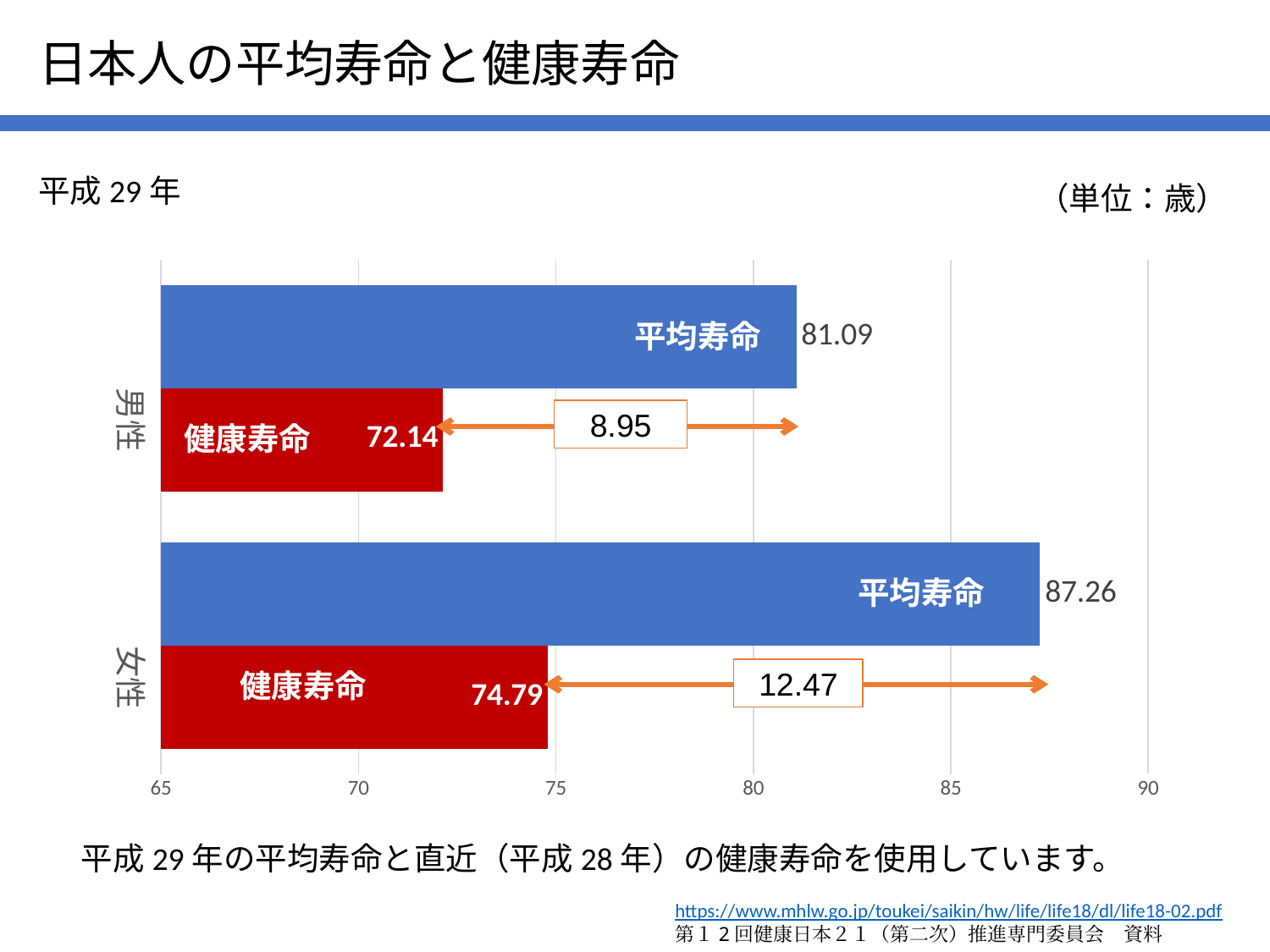
How many categories (groups) are shown on the chart? 2 What unit is indicated for the values on the chart? 歳 What kind of chart is shown on the slide? bar chart Which of the four plotted values is the lowest? 男性 健康寿命 (72.14) What is the difference between 平均寿命 and 健康寿命 for 男性? 8.95 Which group has the higher 平均寿命, 男性 or 女性? 女性 Is the 健康寿命 value for 女性 greater or less than 75? less What is the 健康寿命 value for 女性? 74.79 What is the 平均寿命 value for 男性? 81.09 What is the 平均寿命 value for 女性? 87.26 What is the 健康寿命 value for 男性? 72.14 What is the difference between 平均寿命 and 健康寿命 for 女性? 12.47